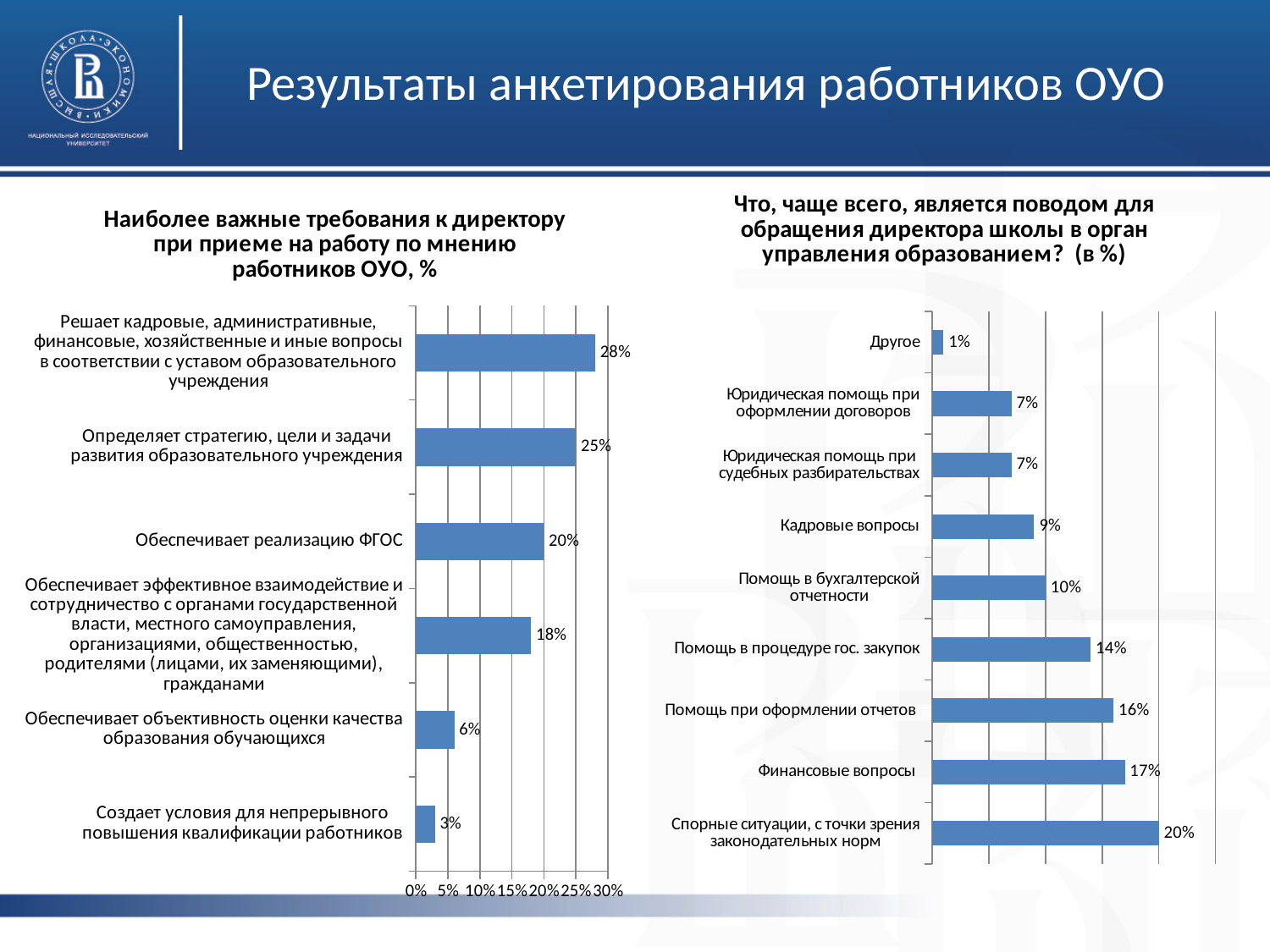
In the left chart (Наиболее важные требования к директору), which category has the highest value? Решает кадровые, административные, финансовые, хозяйственные и иные вопросы в соответствии с уставом образовательного учреждения In the right chart (Что, чаще всего, является поводом для обращения директора школы), what is the value for 'Помощь в процедуре гос. закупок'? 14% In the right chart (Что, чаще всего, является поводом для обращения директора школы), how many categories are shown? 9 In the right chart (Что, чаще всего, является поводом для обращения директора школы), which category has the highest value? Спорные ситуации, с точки зрения законодательных норм In the left chart (Наиболее важные требования к директору), which category has the lowest value? Создает условия для непрерывного повышения квалификации работников What type of chart is the left chart (Наиболее важные требования к директору)? Bar chart In the left chart (Наиболее важные требования к директору), what is the difference between 'Определяет стратегию, цели и задачи развития образовательного учреждения' and 'Обеспечивает объективность оценки качества образования обучающихся'? 19% In the right chart (Что, чаще всего, является поводом для обращения директора школы), which is larger: 'Финансовые вопросы' or 'Кадровые вопросы'? Финансовые вопросы In the right chart (Что, чаще всего, является поводом для обращения директора школы), what is the difference between 'Помощь при оформлении отчетов' and 'Помощь в бухгалтерской отчетности'? 6% In the left chart (Наиболее важные требования к директору), how many categories are shown? 6 In the left chart (Наиболее важные требования к директору), what is the value for 'Обеспечивает реализацию ФГОС'? 20% In the right chart (Что, чаще всего, является поводом для обращения директора школы), which category has the lowest value? Другое